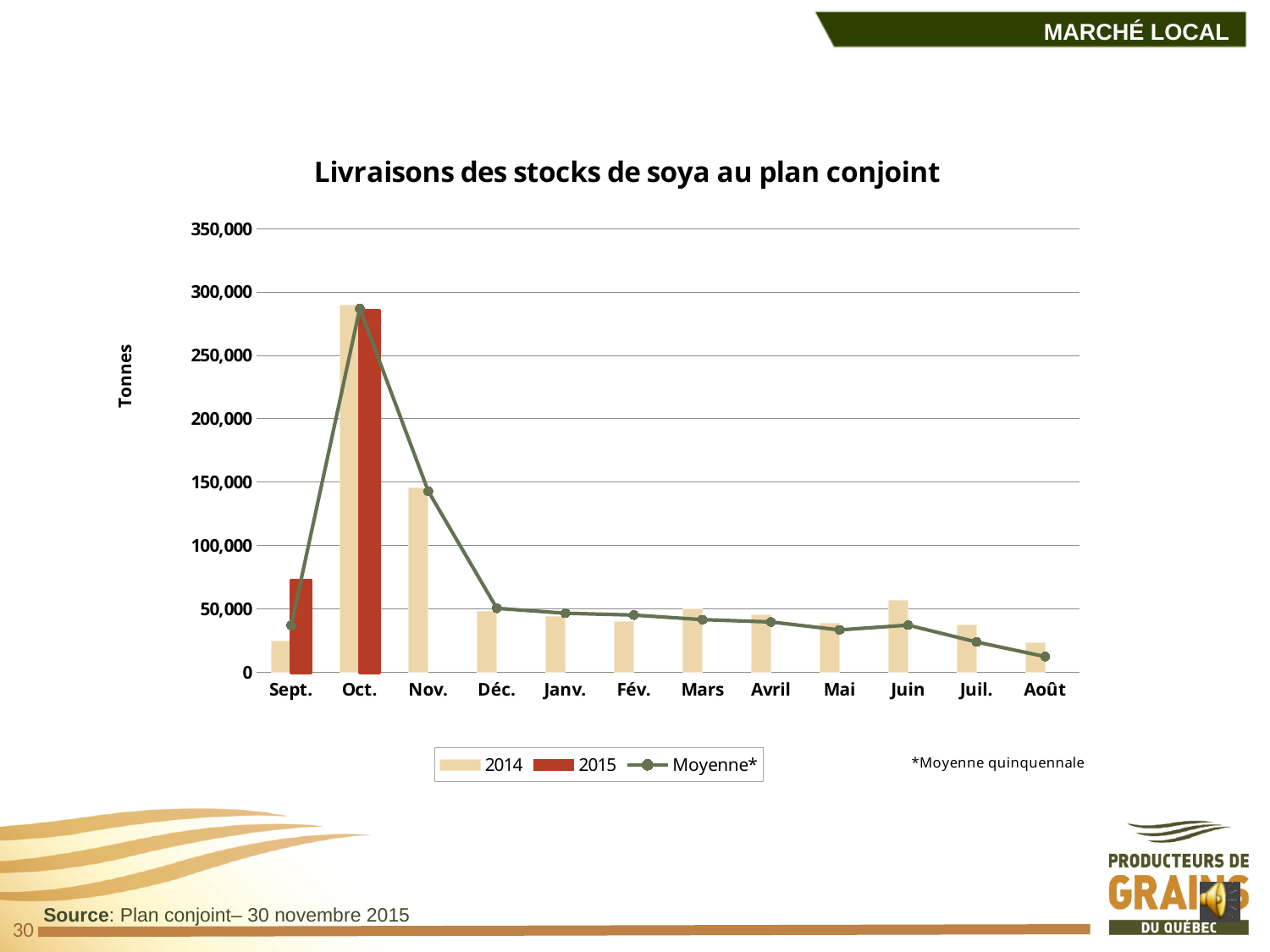
What is the label of the vertical axis? Tonnes What is the title of the chart? Livraisons des stocks de soya au plan conjoint For Sept., which is larger: the 2014 value or the 2015 value? 2015 Is the 2015 value for Sept. greater or less than 50,000? greater How many series does the legend list? 3 Does the Moyenne* line rise or fall from Oct. to Août? fall In which month is the Moyenne* line at its lowest? Août In which month is the 2014 value highest? Oct. Is the 2014 value for Oct. greater or less than 250,000? greater Is the 2014 value for Nov. greater or less than 100,000? greater What kind of chart is shown on the slide? Bar chart with a line How many months are shown on the x axis? 12